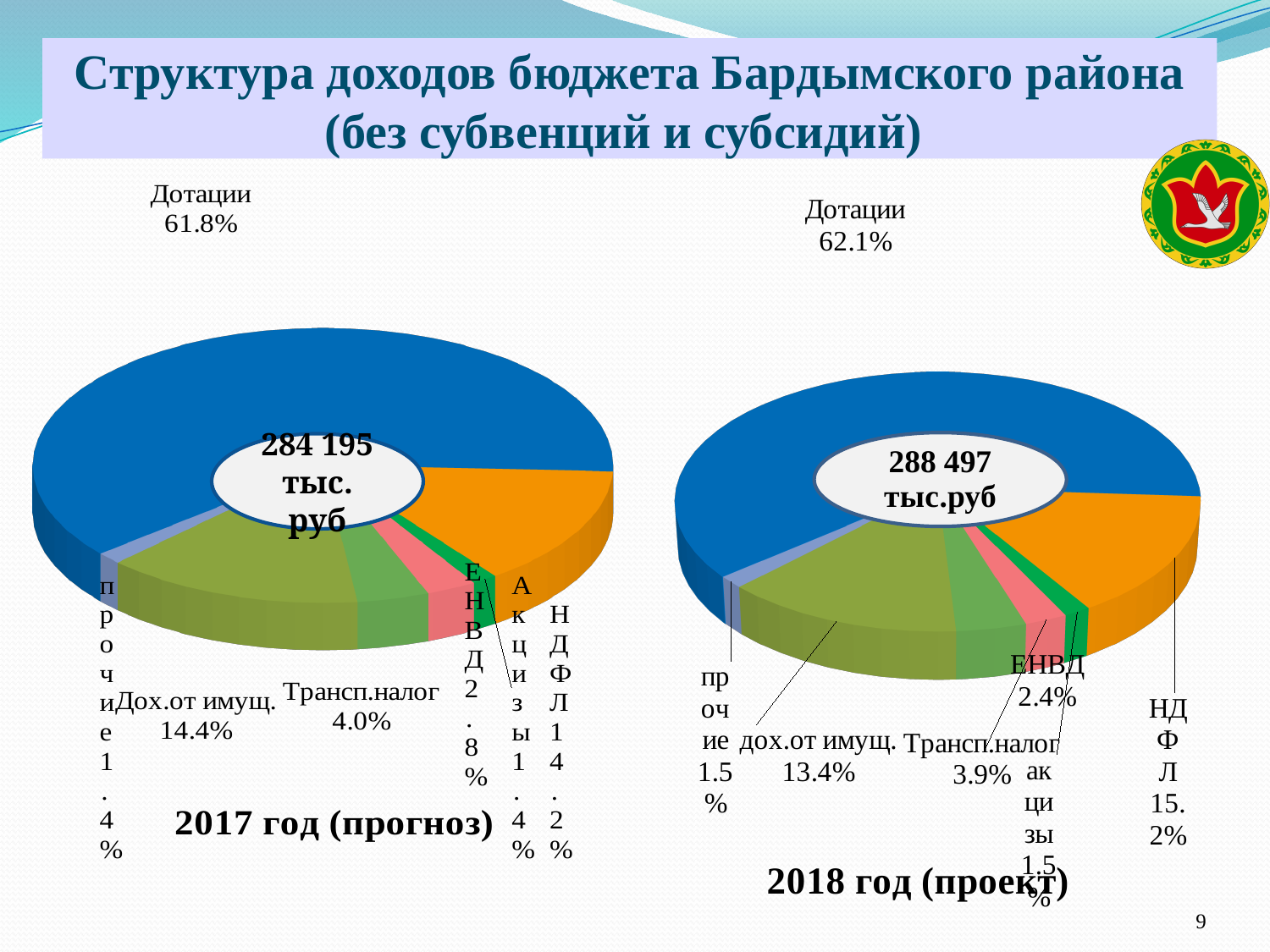
By how many percentage points does the share of Дотации in the 2018 год (проект) chart exceed that in the 2017 год (прогноз) chart? 0.3 How many categories are shown in the 2017 год (прогноз) chart? 7 What kind of chart is used for the 2017 год (прогноз) data? Pie chart In the 2018 год (проект) chart, what is the share of НДФЛ? 15.2% In the 2018 год (проект) chart, what share do Дотации have? 62.1% In the 2017 год (прогноз) chart, what is the share of ЕНВД? 2.8% In the 2018 год (проект) chart, which category has the largest share? Дотации In the 2017 год (прогноз) chart, what share do Дотации have? 61.8% What total amount is shown in the centre of the 2018 год (проект) chart? 288 497 тыс.руб In the 2018 год (проект) chart, what is the share of Трансп.налог? 3.9% Which is larger: the share of НДФЛ in the 2017 год (прогноз) chart or in the 2018 год (проект) chart? 2018 год (проект) In the 2017 год (прогноз) chart, what is the share of Дох.от имущ.? 14.4%